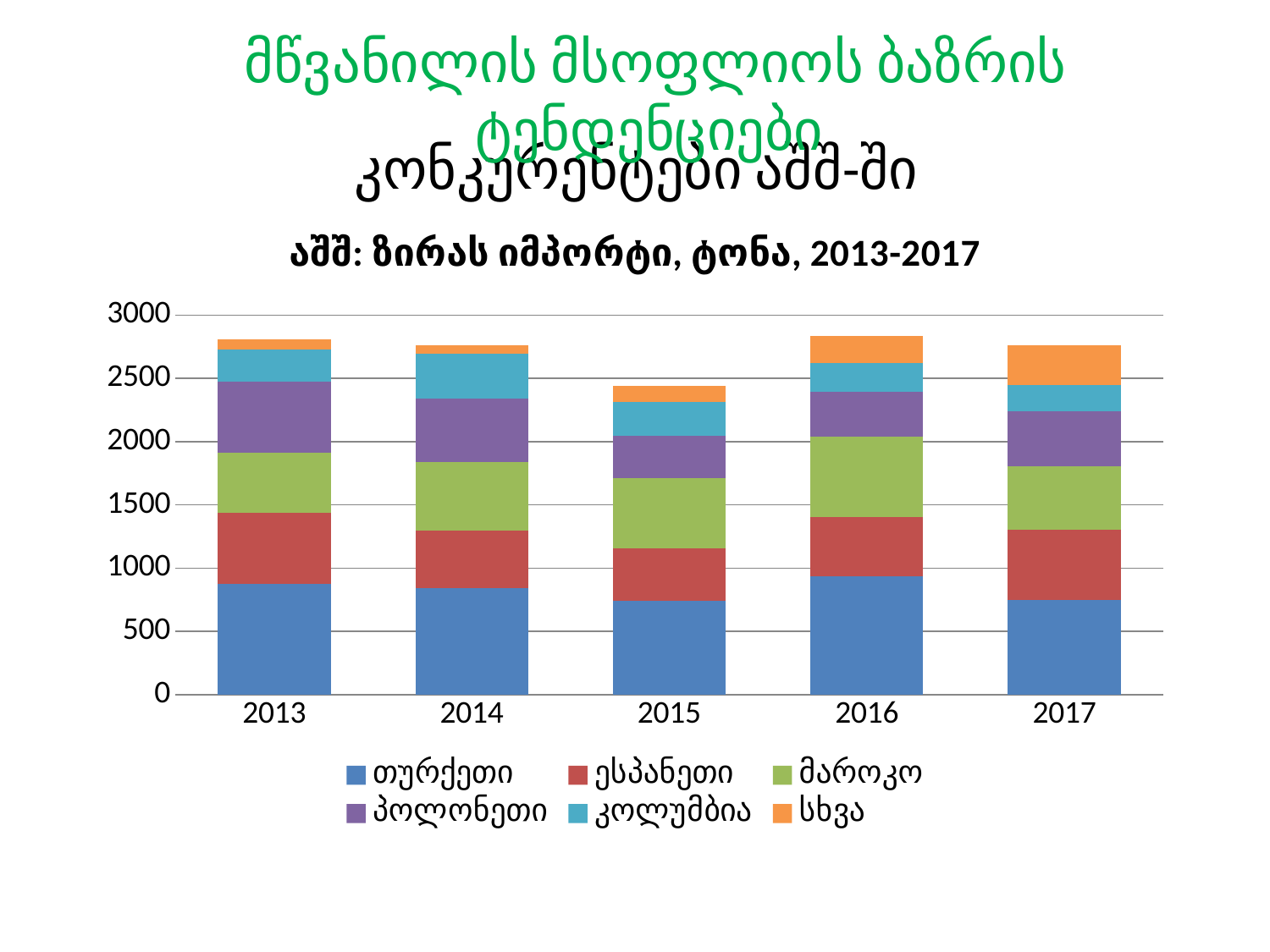
What is the title of the chart? აშშ: ზირას იმპორტი, ტონა, 2013-2017 Which series is shown in blue at the bottom of each stacked bar? თურქეთი How many years are shown on the x axis of the chart? 5 Which year has the lowest total stacked bar? 2015 Is the total stacked bar for 2015 greater or less than 2500? less Do the total stacked bars rise or fall from 2013 to 2015? fall What kind of chart is shown on the slide? stacked bar chart Is the value for თურქეთი in 2016 greater or less than 500? greater Which year has the larger total stacked bar, 2015 or 2016? 2016 Is the total stacked bar for 2013 greater or less than 2500? greater How many series does the chart's legend list? 6